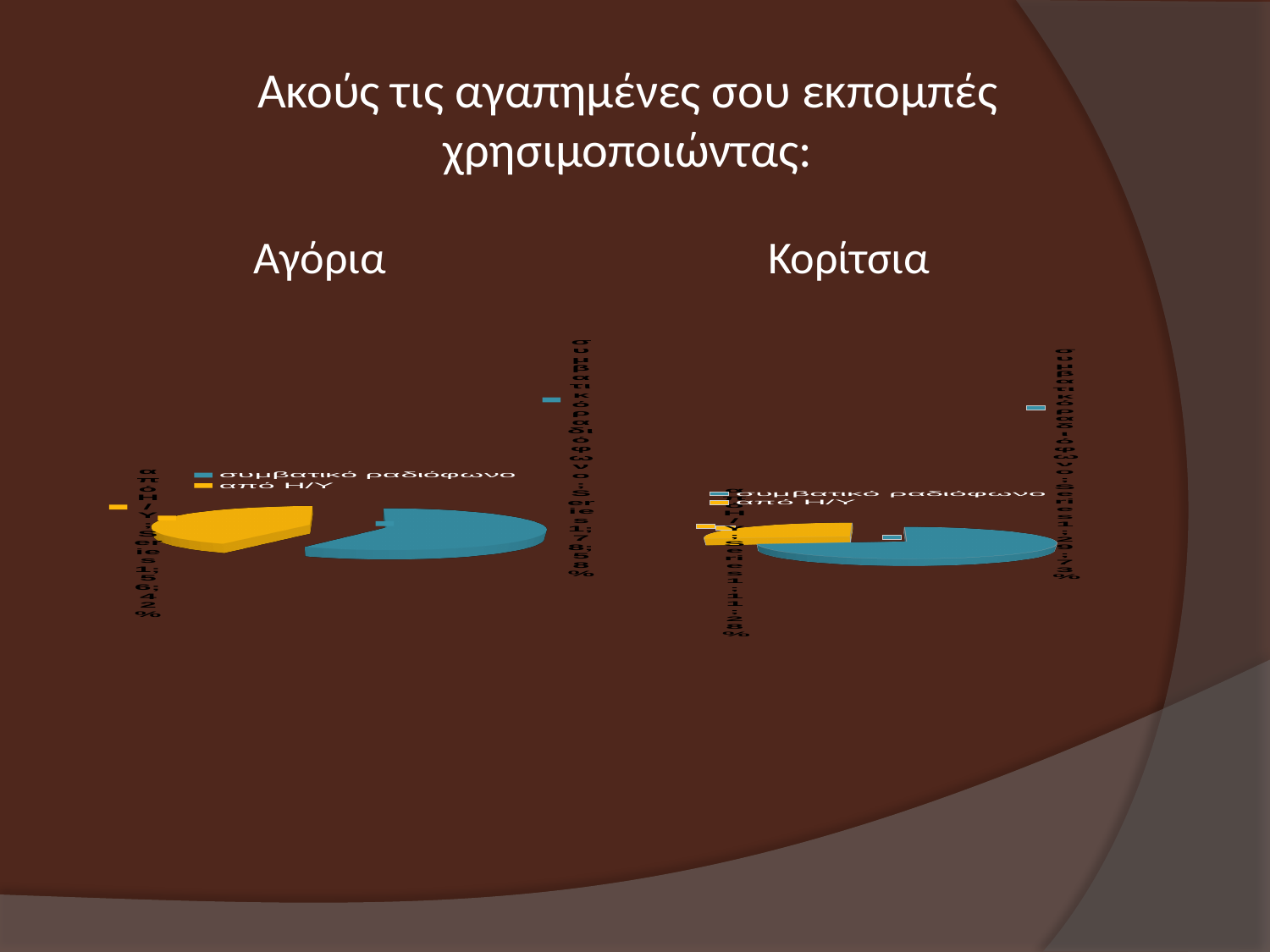
What are the two legend entries in the Κορίτσια chart? συμβατικό ραδιόφωνο and από Η/Υ In the Αγόρια chart, which category has the largest slice? συμβατικό ραδιόφωνο In the Κορίτσια chart, which slice is larger: συμβατικό ραδιόφωνο or από Η/Υ? συμβατικό ραδιόφωνο In the Κορίτσια chart, how many slices does the pie have? 2 In the Αγόρια chart, how many entries does the legend list? 2 What kind of chart is the Αγόρια chart? pie chart In the Κορίτσια chart, how many entries does the legend list? 2 What kind of chart is the Κορίτσια chart? pie chart In the Αγόρια chart, which slice is larger: συμβατικό ραδιόφωνο or από Η/Υ? συμβατικό ραδιόφωνο In the Αγόρια chart, how many slices does the pie have? 2 In the Κορίτσια chart, which category has the smallest slice? από Η/Υ In the Αγόρια chart, what colour is the από Η/Υ slice? yellow